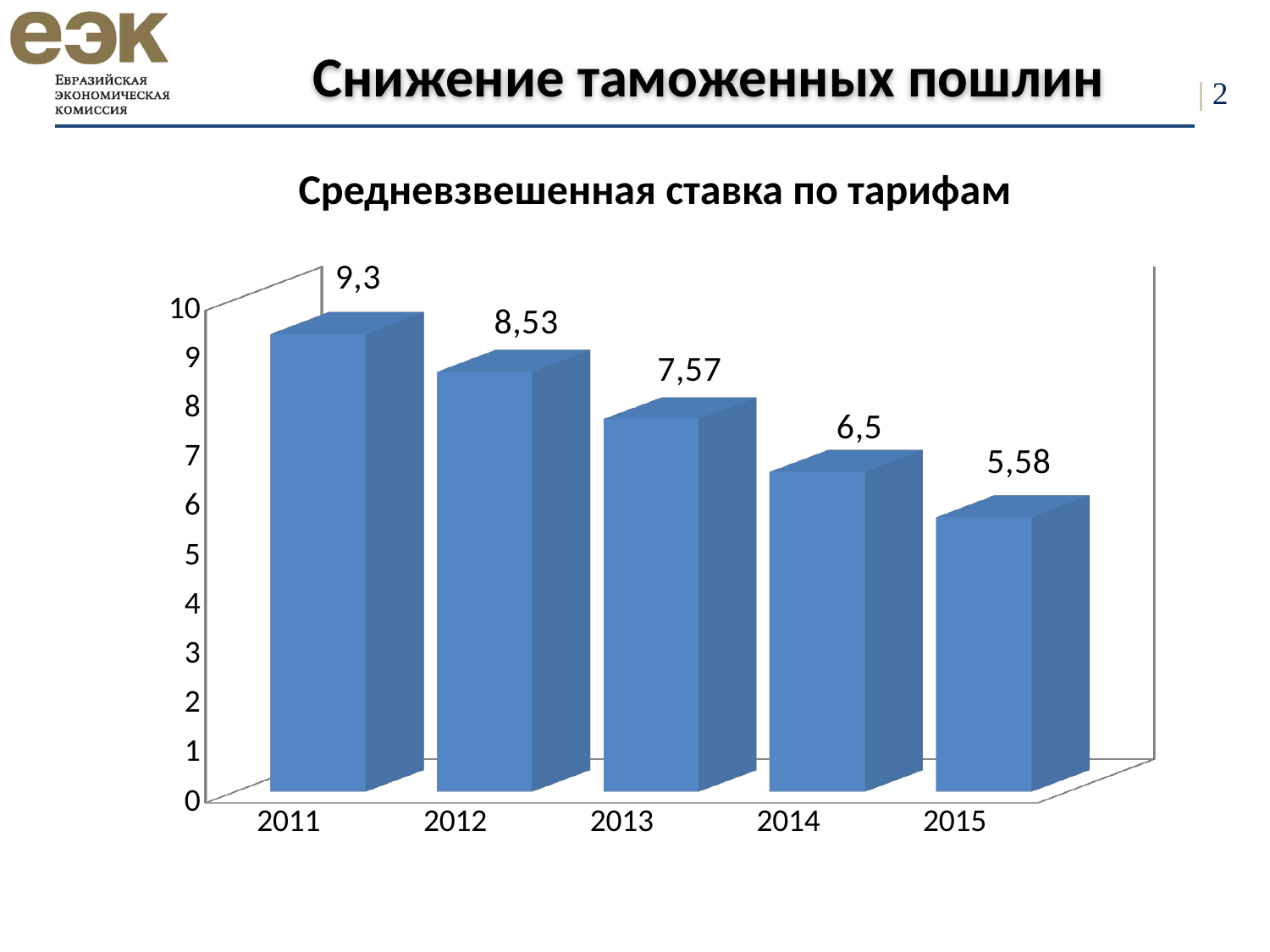
What kind of chart is shown on the slide? bar chart How many years are shown on the chart? 5 Which year has the lowest value? 2015 Is the value for 2014 greater or less than 7? less Which is larger, the value for 2012 or the value for 2014? 2012 What is the difference between the values for 2011 and 2015? 3,72 What is the value for 2011? 9,3 Do the values rise or fall from 2011 to 2015? fall What is the difference between the values for 2012 and 2013? 0,96 What is the value for 2015? 5,58 What is the value for 2013? 7,57 Which year has the highest value? 2011